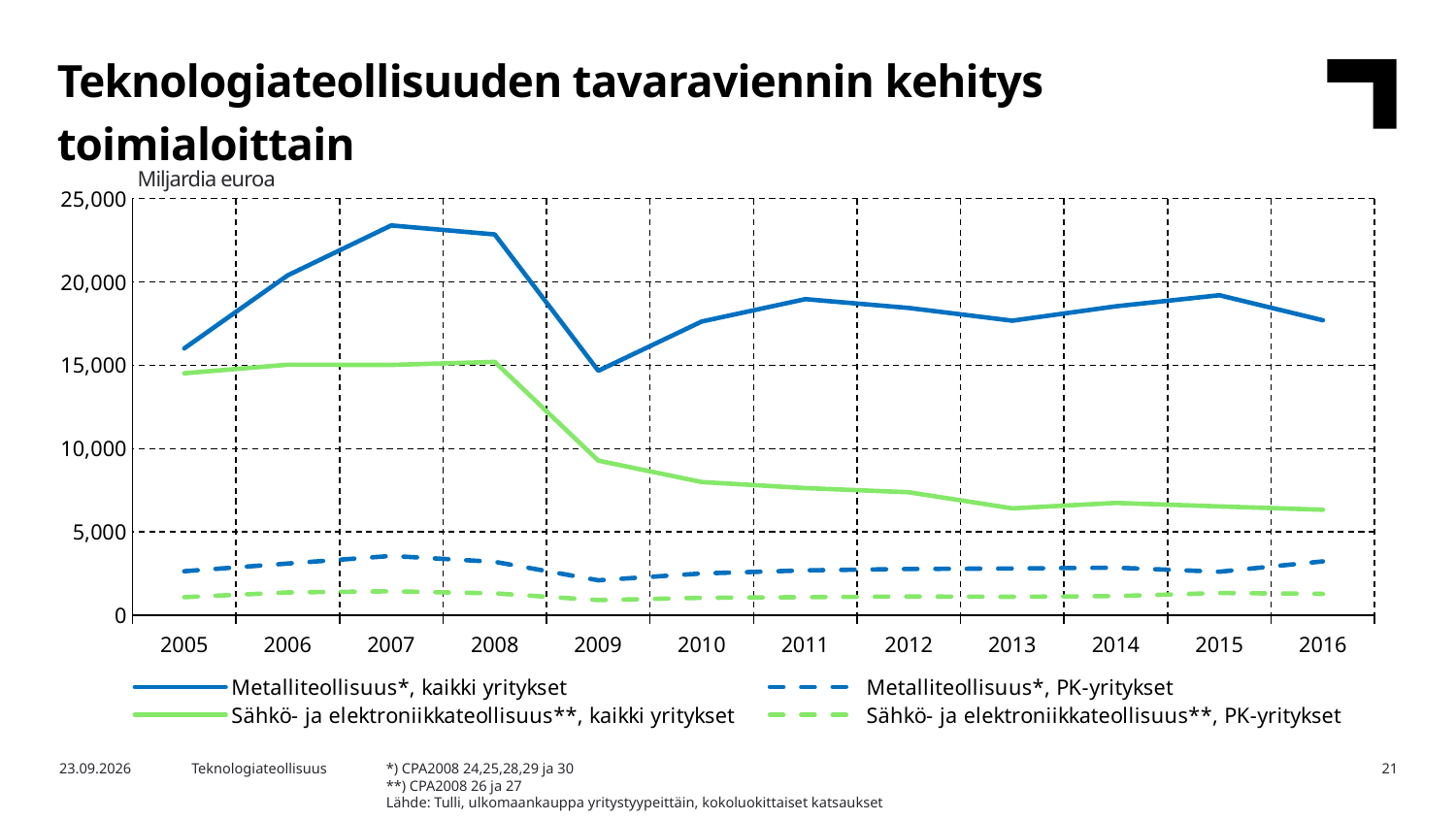
In 2016, which is higher: Metalliteollisuus*, kaikki yritykset or Sähkö- ja elektroniikkateollisuus**, kaikki yritykset? Metalliteollisuus*, kaikki yritykset How many series does the legend list? 4 In 2010, which is higher: Metalliteollisuus*, PK-yritykset or Sähkö- ja elektroniikkateollisuus**, PK-yritykset? Metalliteollisuus*, PK-yritykset In which year is the value for Metalliteollisuus*, kaikki yritykset lowest? 2009 Does the value for Sähkö- ja elektroniikkateollisuus**, kaikki yritykset rise or fall from 2008 to 2016? fall Does the value for Metalliteollisuus*, kaikki yritykset rise or fall from 2005 to 2007? rise Is the value for Sähkö- ja elektroniikkateollisuus**, PK-yritykset in 2005 greater or less than 5,000? less Is the value for Sähkö- ja elektroniikkateollisuus**, kaikki yritykset in 2016 greater or less than 10,000? less What type of chart is shown on the slide? Line chart How many years are shown on the x axis? 12 What unit label is shown above the y axis of the chart? Miljardia euroa Is the value for Metalliteollisuus*, kaikki yritykset in 2007 greater or less than 20,000? greater